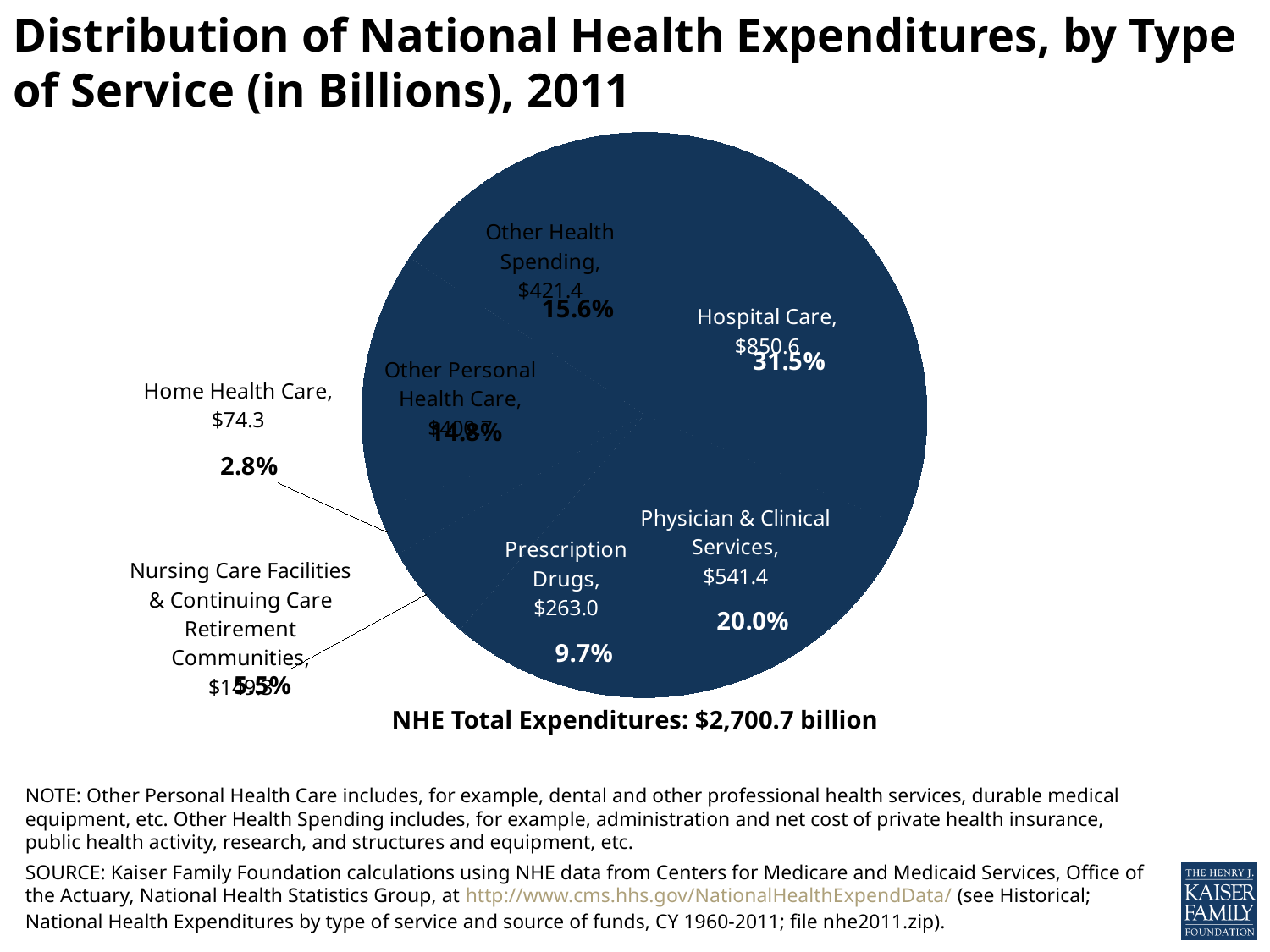
What is the expenditure value shown for Physician & Clinical Services? $541.4 What is the expenditure value shown for Home Health Care? $74.3 What is the NHE total expenditure shown on the slide? $2,700.7 billion Which type of service has the smallest share of national health expenditures? Home Health Care What share of national health expenditures do Prescription Drugs account for? 9.7% Which type of service has the largest share of national health expenditures? Hospital Care What is the difference in expenditures between Hospital Care and Physician & Clinical Services? $309.2 What kind of chart is shown on the slide? pie chart What share of national health expenditures does Other Health Spending account for? 15.6% How many types of service are shown in the chart? 7 What is the expenditure value shown for Hospital Care? $850.6 What share of national health expenditures does Hospital Care account for? 31.5%